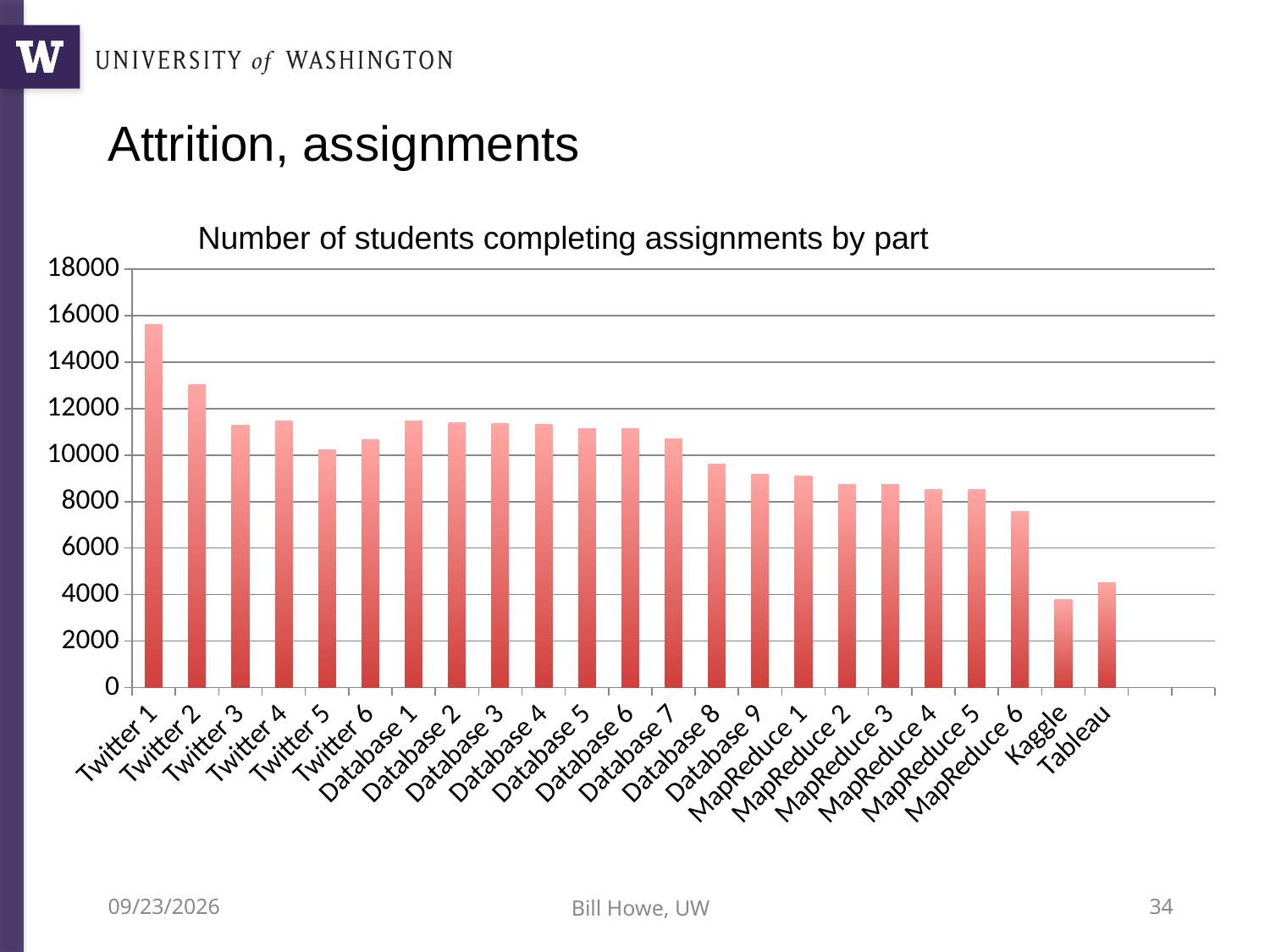
What kind of chart is shown on the slide? bar chart What is the title of the chart? Number of students completing assignments by part Is the value for Twitter 1 greater or less than 14000? greater Which has more students completing it, Tableau or Kaggle? Tableau Is the value for Database 1 greater or less than 10000? greater How many assignment parts (categories) are shown on the x axis? 23 Is the value for MapReduce 6 greater or less than 8000? less Do the values generally rise or fall from Database 1 to Database 9? fall Which has more students completing it, Twitter 2 or Database 1? Twitter 2 Which assignment part has the lowest number of students completing it? Kaggle Which assignment part has the highest number of students completing it? Twitter 1